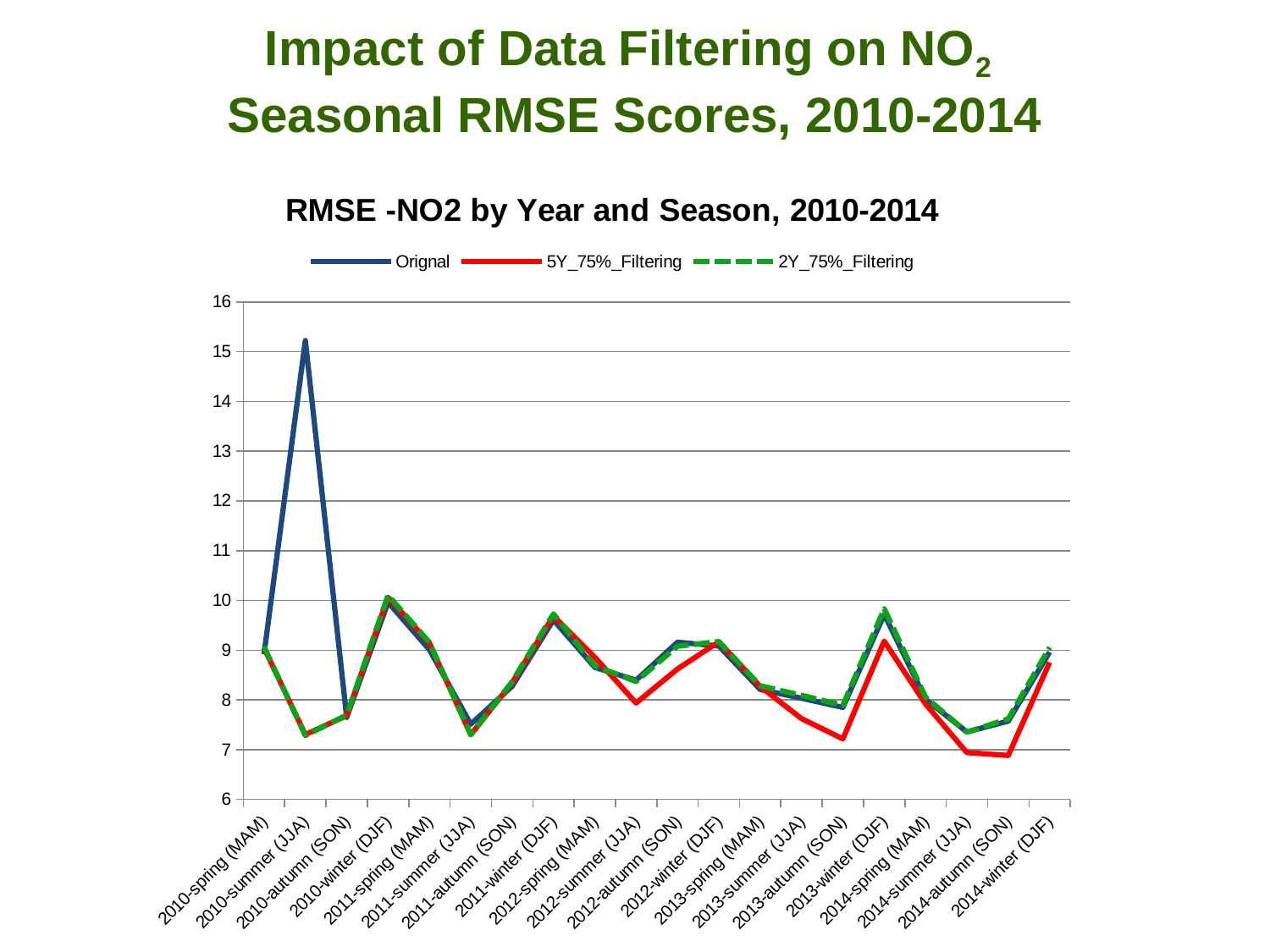
How many year-season categories are plotted along the x axis? 20 Does the Orignal series rise or fall from 2010-spring (MAM) to 2010-summer (JJA)? rise Is the Orignal value for 2010-winter (DJF) greater or less than 9? greater Is the 2Y_75%_Filtering value for 2013-winter (DJF) greater or less than 9? greater What kind of chart is shown on the slide? line chart How many series does the legend list? 3 Is the 5Y_75%_Filtering value for 2014-autumn (SON) greater or less than 8? less What is the title of the chart? RMSE -NO2 by Year and Season, 2010-2014 At 2010-summer (JJA), which series has the larger value, Orignal or 5Y_75%_Filtering? Orignal At 2013-autumn (SON), which series has the larger value, Orignal or 5Y_75%_Filtering? Orignal For the Orignal series, which category has the highest RMSE value? 2010-summer (JJA)